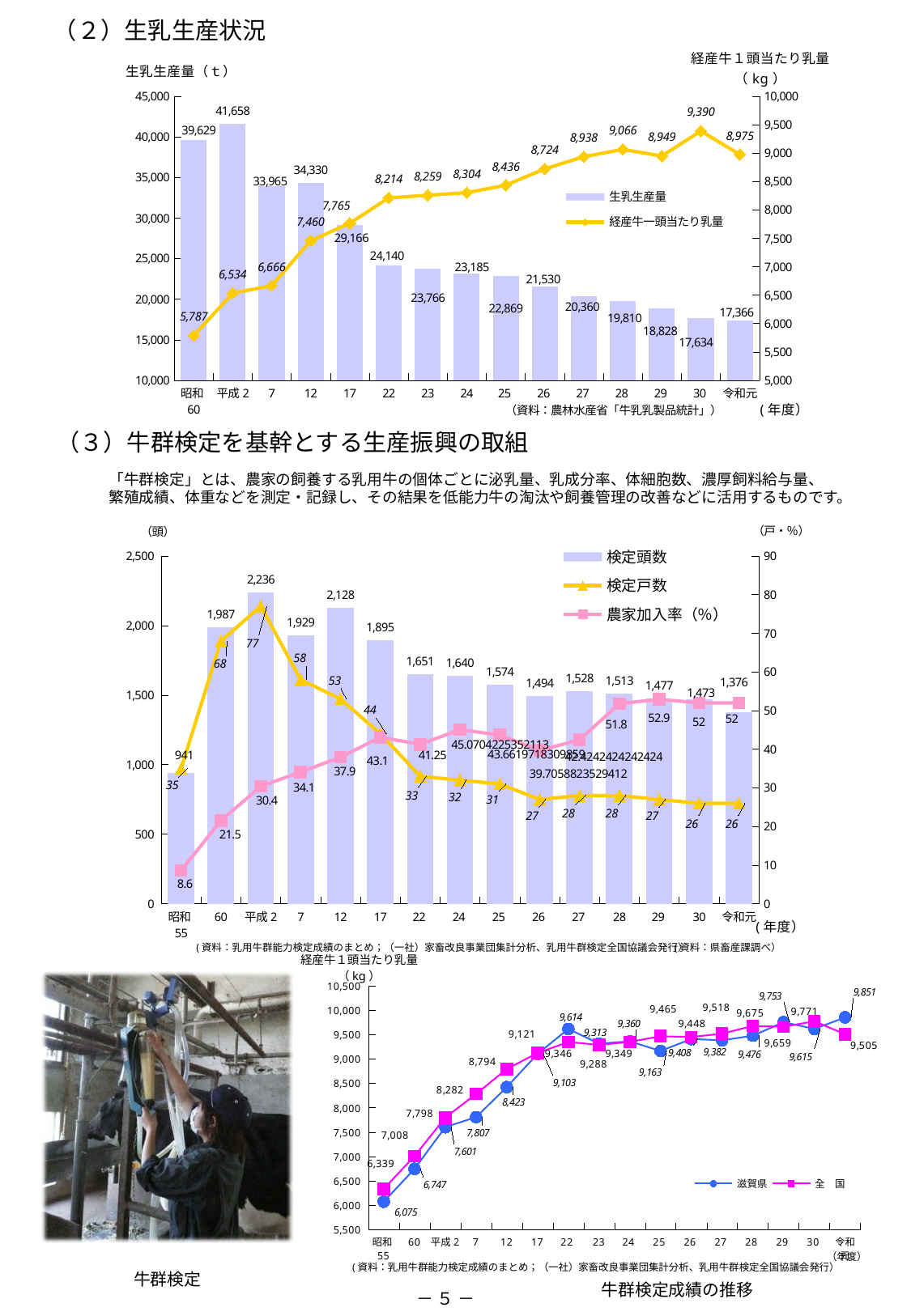
In the middle chart (検定頭数), what is the 検定頭数 value for 平成2? 2,236 In the bottom-right chart (牛群検定成績の推移), how many years are plotted on the x axis? 16 In the top chart (生乳生産状況), what is the 経産牛一頭当たり乳量 value for 30? 9,390 In the bottom-right chart (牛群検定成績の推移), which is larger at 昭和55: 滋賀県 or 全国? 全国 In the top chart (生乳生産状況), what is the difference in 生乳生産量 between 昭和60 and 令和元? 22,263 In the top chart (生乳生産状況), does the 生乳生産量 bar series generally rise or fall from 平成2 to 令和元? fall In the middle chart (検定頭数), how many series does the legend list? 3 In the top chart (生乳生産状況), which year has the lowest 生乳生産量? 令和元 In the top chart (生乳生産状況), what is the 生乳生産量 value for 平成2? 41,658 In the middle chart (検定頭数), what is the 検定戸数 value for 昭和55? 35 In the bottom-right chart (牛群検定成績の推移), what is the 滋賀県 value for 令和元? 9,851 In the middle chart (検定頭数), which year has the highest 検定頭数? 平成2